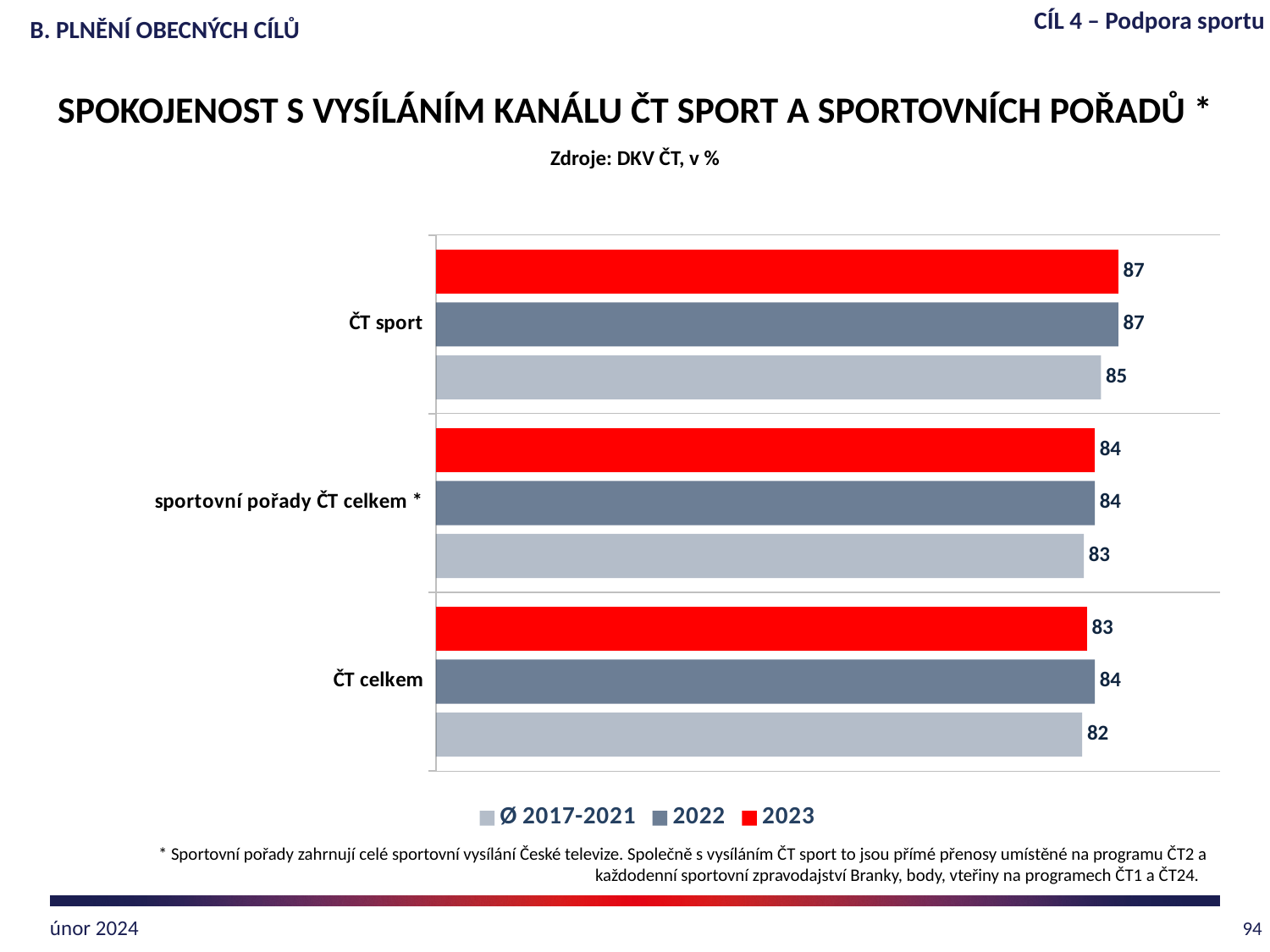
What kind of chart is shown on the slide? bar chart What is the difference between the 2023 value for ČT sport and the 2023 value for ČT celkem? 4 Which series is shown in red in the legend? 2023 How many series does the legend list? 3 What is the 2023 value for ČT celkem? 83 What is the 2022 value for sportovní pořady ČT celkem? 84 What is the Ø 2017-2021 value for ČT celkem? 82 For ČT celkem, which is larger: the 2022 value or the 2023 value? 2022 Which category has the highest Ø 2017-2021 value? ČT sport Which category has the lowest 2023 value? ČT celkem What is the 2023 value for ČT sport? 87 How many categories are shown on the chart? 3